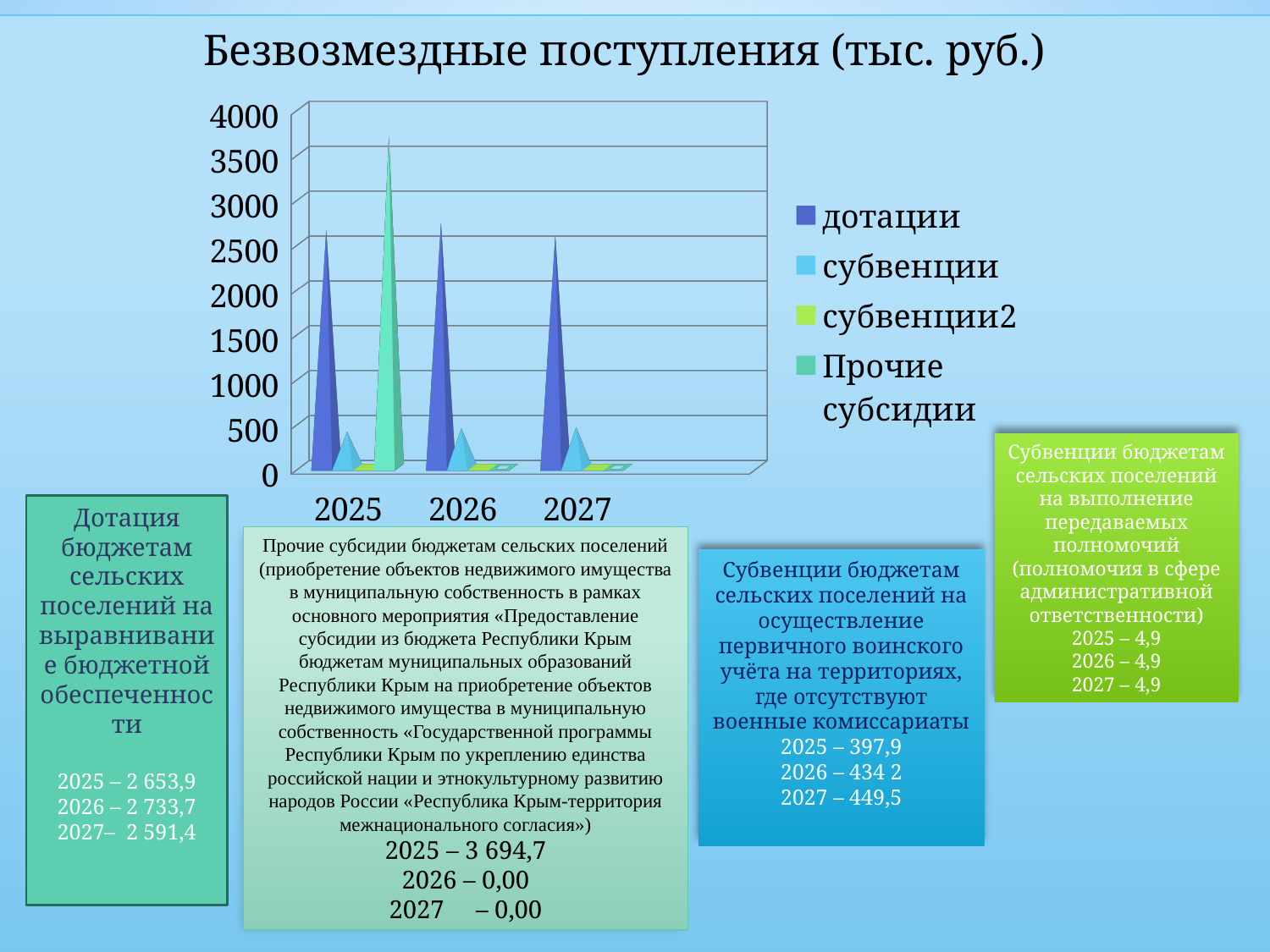
What is the title of the chart? Безвозмездные поступления (тыс. руб.) Is the value for субвенции in 2025 greater or less than 500? less How many years (categories) are shown on the x axis of the chart? 3 How many series does the chart legend list? 4 According to the text box on the slide, what is the value of субвенции (первичный воинский учёт) for 2027? 449,5 Which is larger in 2025: дотации or субвенции? дотации Which series has the tallest bar in the chart? Прочие субсидии Is the value for дотации in 2026 greater or less than 2000? greater Do the values for Прочие субсидии rise or fall from 2025 to 2027? fall Is the value for Прочие субсидии in 2025 greater or less than 3500? greater Which is larger in 2025: Прочие субсидии or дотации? Прочие субсидии What type of chart is shown on the slide? bar chart